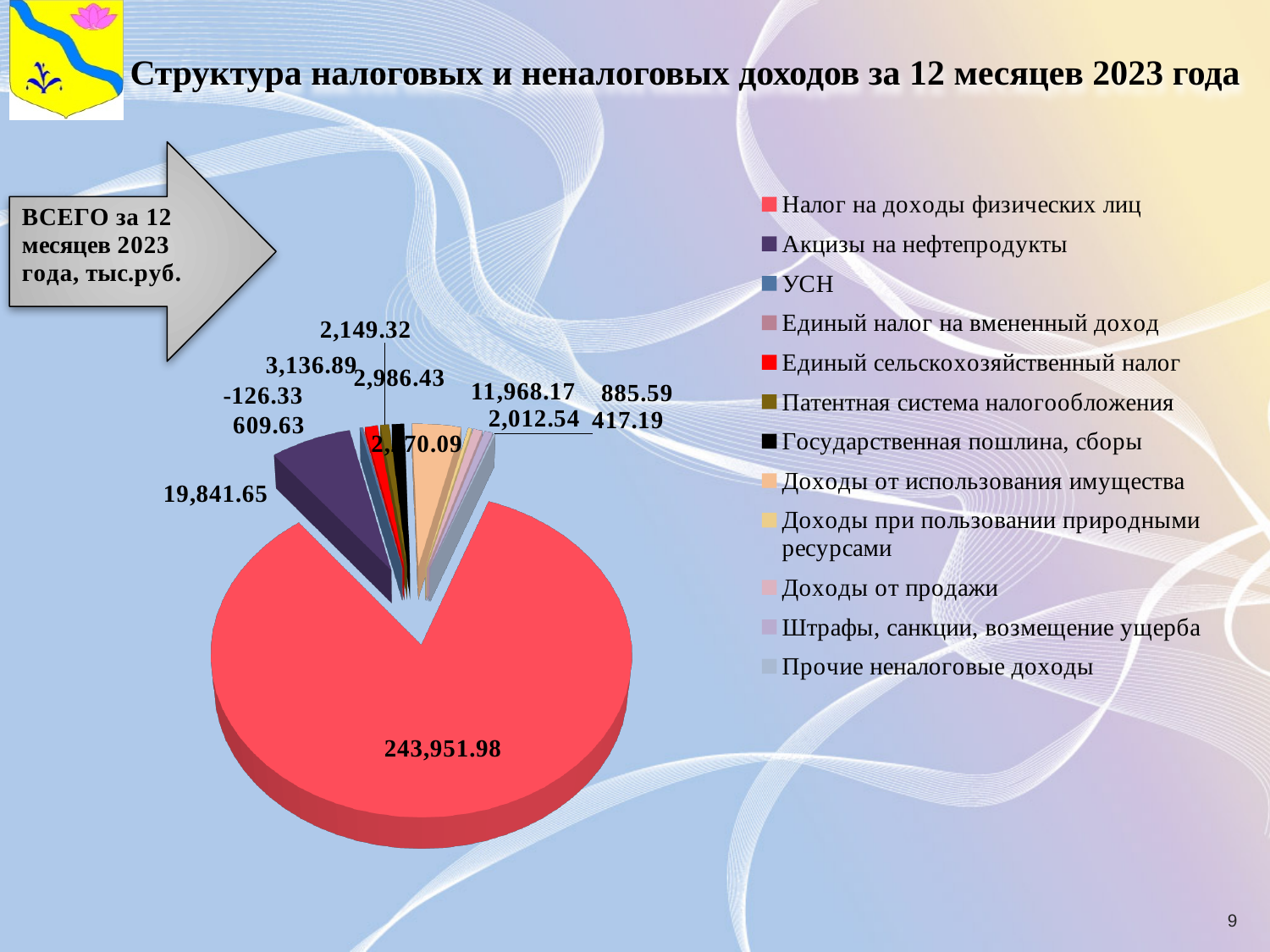
Which category has the largest slice of the pie chart? Налог на доходы физических лиц What colour is the legend marker for Государственная пошлина, сборы? black In what units are the values on the chart given, according to the arrow box on the slide? тыс.руб. What is the value shown for Акцизы на нефтепродукты? 19,841.65 What kind of chart is shown on the slide? pie chart What is the title of the slide's chart? Структура налоговых и неналоговых доходов за 12 месяцев 2023 года What is the value shown for Налог на доходы физических лиц? 243,951.98 How many categories does the legend of the pie chart list? 12 What is the smallest value printed as a data label on the pie chart? -126.33 What is the largest value printed as a data label on the pie chart? 243,951.98 What is the difference between the value for Налог на доходы физических лиц and the value for Акцизы на нефтепродукты? 224,110.33 Which is larger: the value for Налог на доходы физических лиц or the value for Акцизы на нефтепродукты? Налог на доходы физических лиц